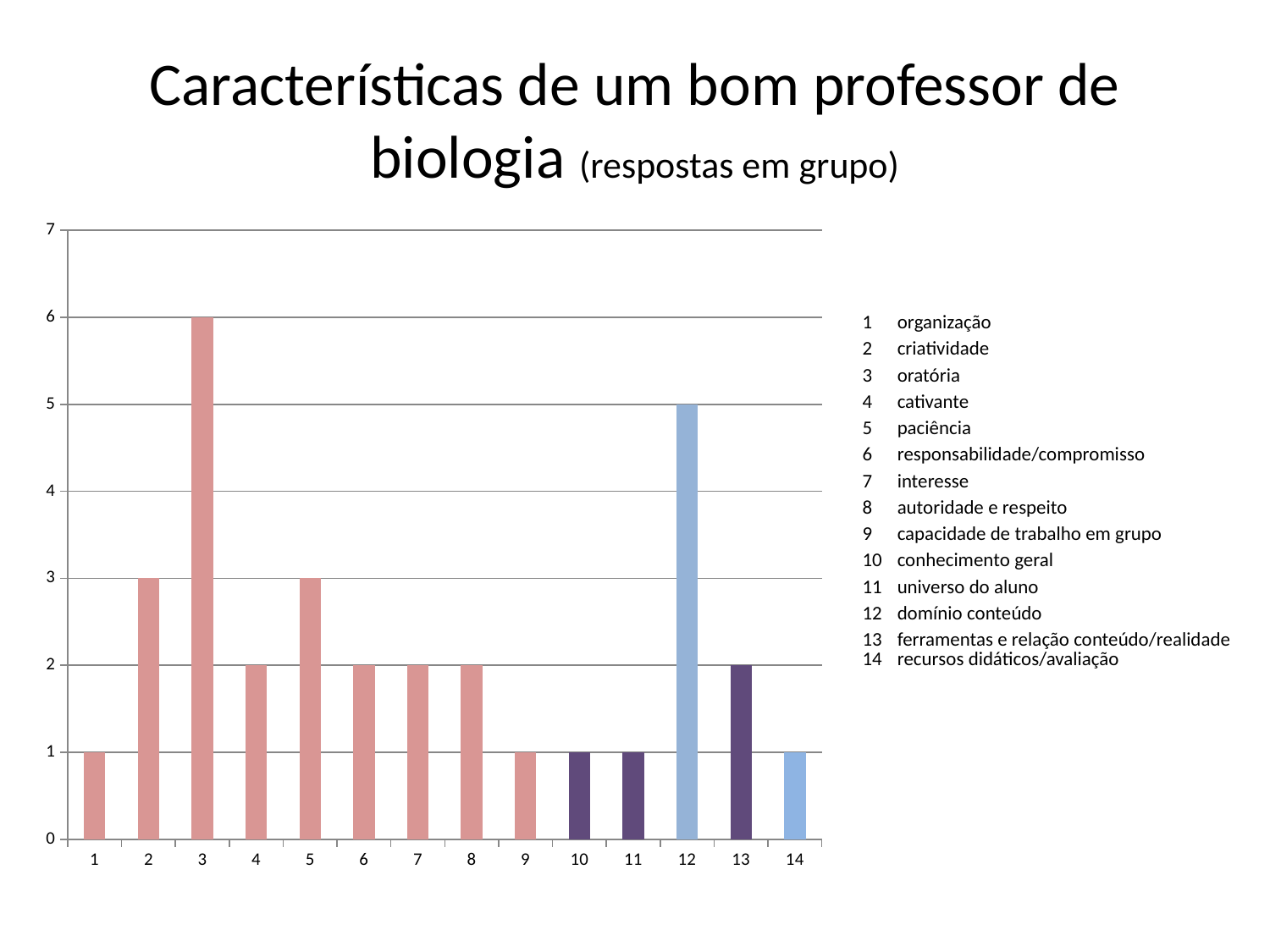
Which category has the highest value? 3 What is the difference between the values for category 3 and category 12? 1 What is the value for category 5 (paciência)? 3 What is the value for category 3 (oratória)? 6 What is the total of the values for categories 10 and 11? 2 What is the value for category 12 (domínio conteúdo)? 5 Which is larger, the value for category 2 or the value for category 4? category 2 What is the value for category 13 (ferramentas e relação conteúdo/realidade)? 2 What is the highest value shown on the y axis? 7 How many categories are plotted on the x axis? 14 Is the value for category 12 greater or less than 4? greater What type of chart is shown on the slide? bar chart